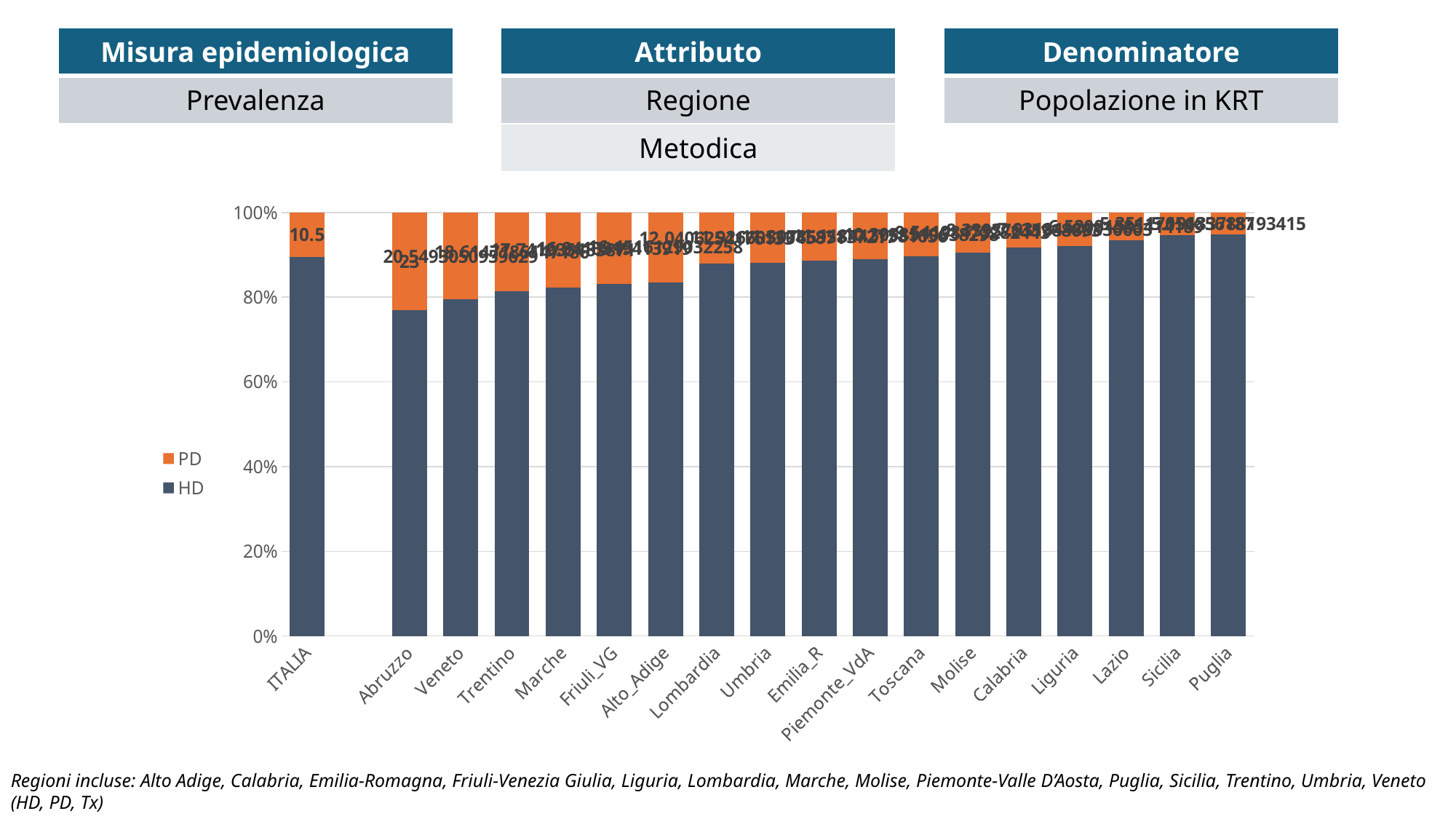
Which has the larger PD share, Abruzzo or Puglia? Abruzzo How many categories are shown on the x axis of the chart? 18 Which region has the largest HD share? Puglia How many series does the legend list? 2 Is the HD share for Lombardia greater or less than 80%? greater What kind of chart is shown on the slide? stacked bar chart Moving from Abruzzo to Puglia along the x axis, does the HD share rise or fall? rise What is the data label shown for the PD segment of the ITALIA bar? 10.5 Which colour represents the PD series in the legend? orange Which region has the smallest PD share? Puglia Which region has the largest PD share? Abruzzo Is the HD share for Abruzzo greater or less than 80%? less